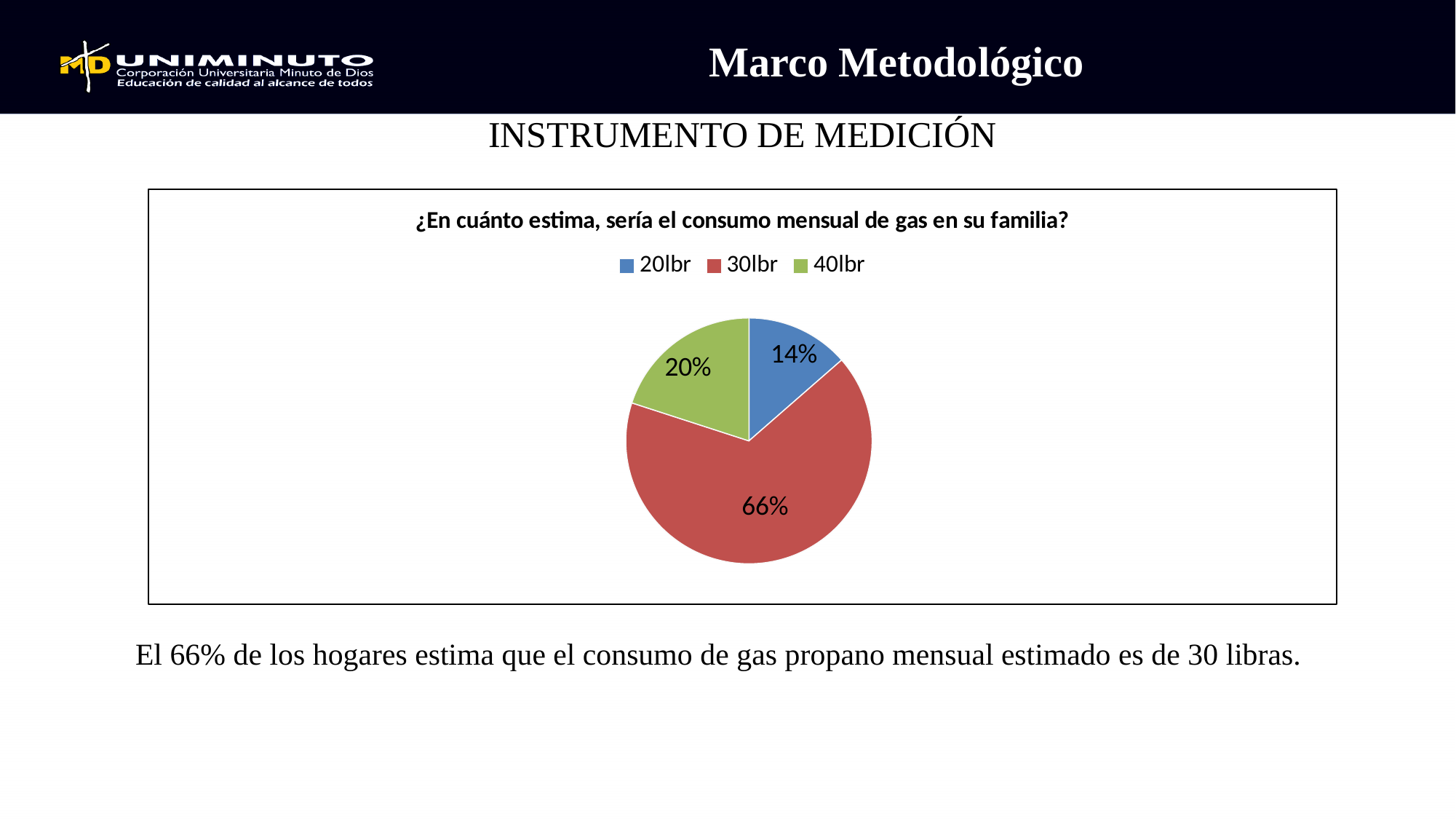
What share of the pie corresponds to 40lbr? 20% Which category has the largest slice of the pie? 30lbr What colour is the slice for 30lbr? red What share of the pie corresponds to 20lbr? 14% How many categories does the pie chart show? 3 What share of the pie corresponds to 30lbr? 66% Which slice is larger, 20lbr or 40lbr? 40lbr Which category has the smallest slice of the pie? 20lbr What is the title of the chart? ¿En cuánto estima, sería el consumo mensual de gas en su familia? What kind of chart is shown on the slide? pie chart What is the difference in percentage points between the 30lbr slice and the 40lbr slice? 46 What is the difference in percentage points between the 40lbr slice and the 20lbr slice? 6